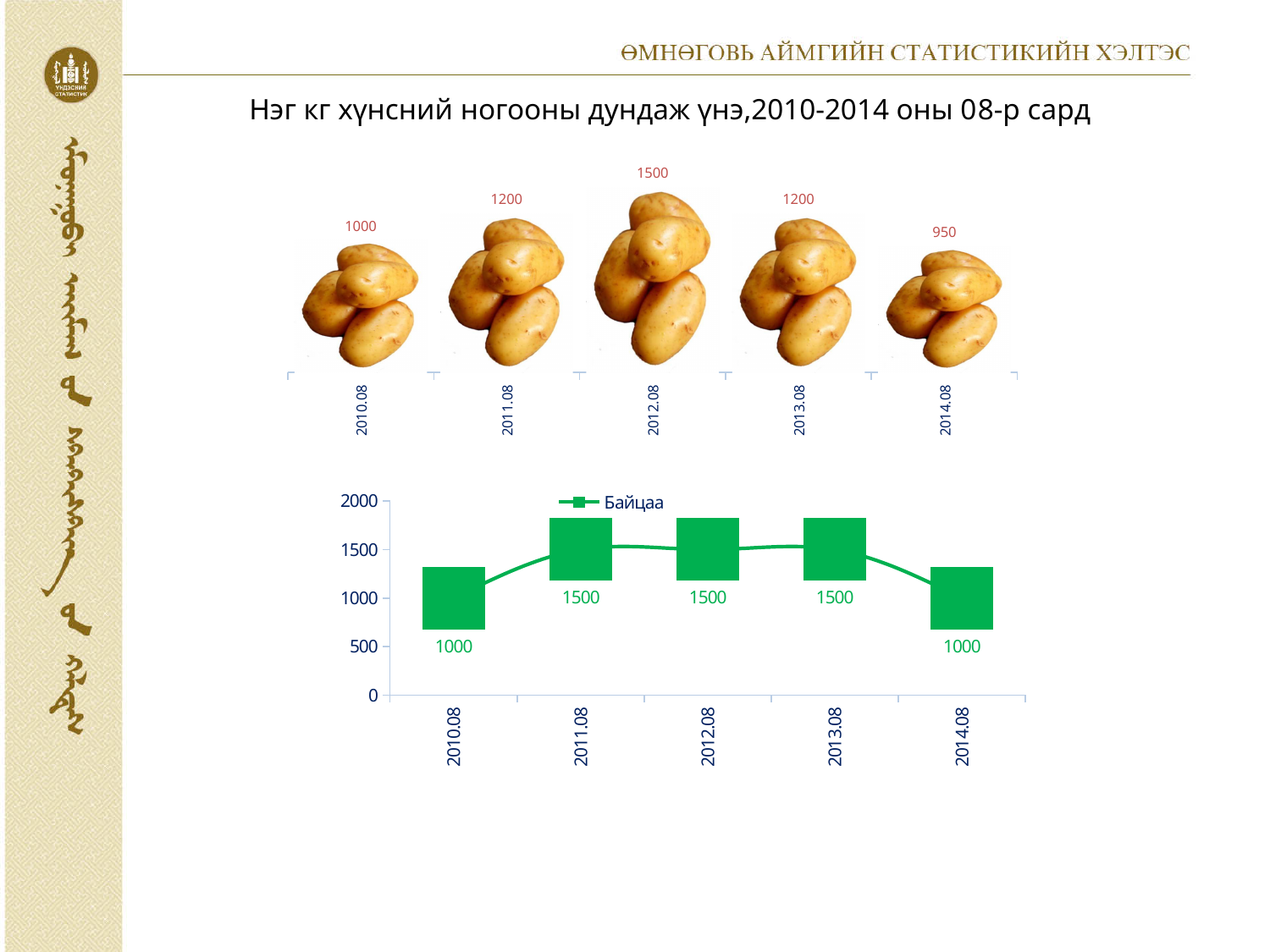
In the top chart with potato images, how many periods are shown on the x axis? 5 In the bottom chart, what is the name of the series shown in the legend? Байцаа In the top chart with potato images, what is the value for 2014.08? 950 In the bottom chart (Байцаа), what is the value for 2014.08? 1000 In the top chart with potato images, which period has the lowest value? 2014.08 In the bottom chart (Байцаа), what is the difference between the values for 2012.08 and 2014.08? 500 In the bottom chart (Байцаа), how many series does the legend list? 1 In the top chart with potato images, what is the value for 2012.08? 1500 In the top chart with potato images, what is the difference between the values for 2012.08 and 2010.08? 500 In the bottom chart (Байцаа), what is the value for 2011.08? 1500 In the top chart with potato images, which period has the highest value? 2012.08 In the bottom chart (Байцаа), which is larger, the value for 2010.08 or the value for 2013.08? 2013.08